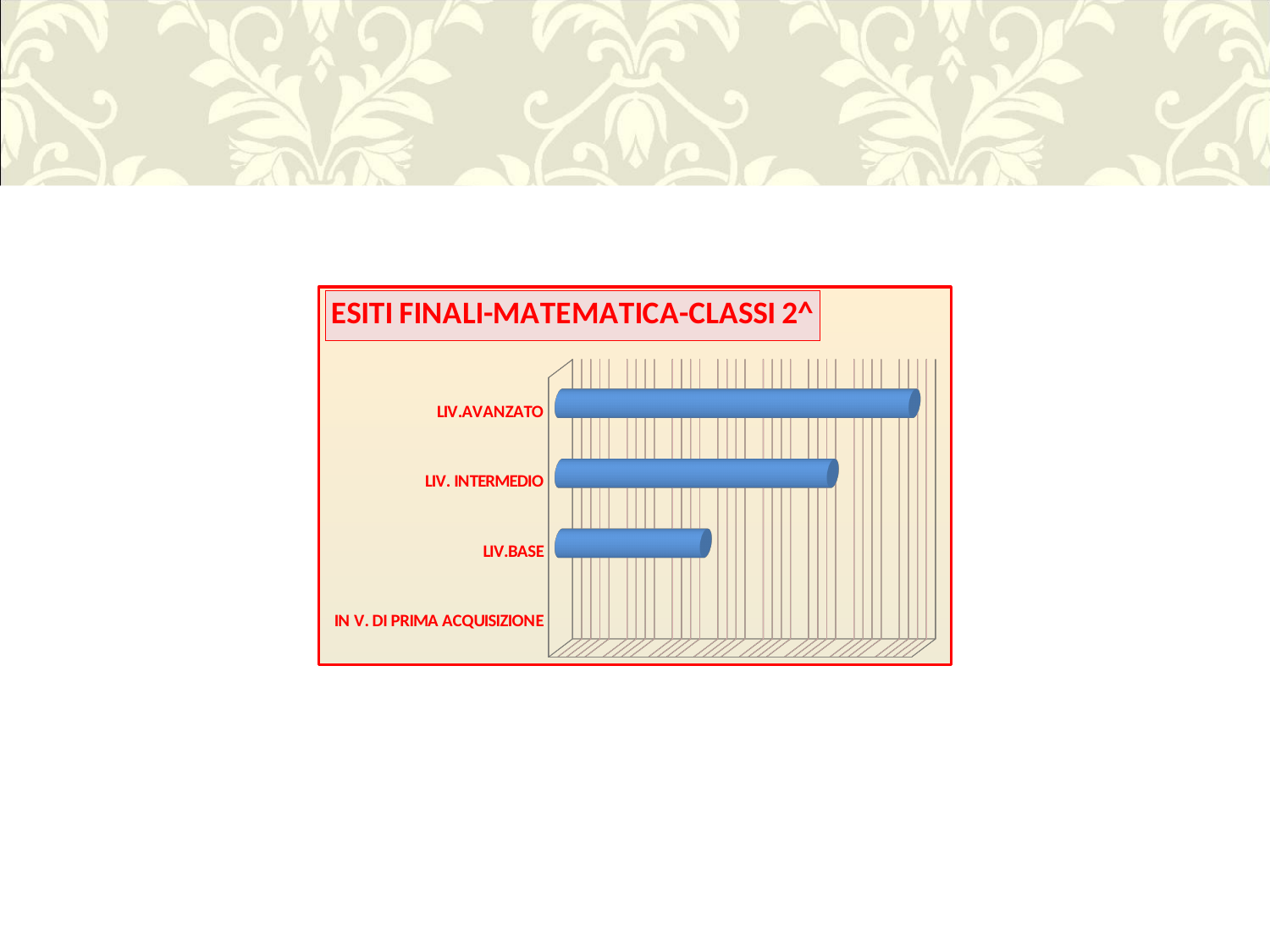
Which is larger, the value for LIV.AVANZATO or the value for LIV. INTERMEDIO? LIV.AVANZATO Which category has the second-longest bar? LIV. INTERMEDIO Do the bar lengths increase or decrease going from LIV.AVANZATO down to IN V. DI PRIMA ACQUISIZIONE? Decrease What kind of chart is shown on the slide? Bar chart Which category has the smallest value on the chart? IN V. DI PRIMA ACQUISIZIONE How many categories are listed on the chart's vertical axis? 4 Does the category IN V. DI PRIMA ACQUISIZIONE have a visible bar on the chart? No Which category has the longest bar? LIV.AVANZATO What is the title of the chart? ESITI FINALI-MATEMATICA-CLASSI 2^ Which is larger, the value for LIV. INTERMEDIO or the value for LIV.BASE? LIV. INTERMEDIO Among the categories with a visible bar, which has the shortest bar? LIV.BASE